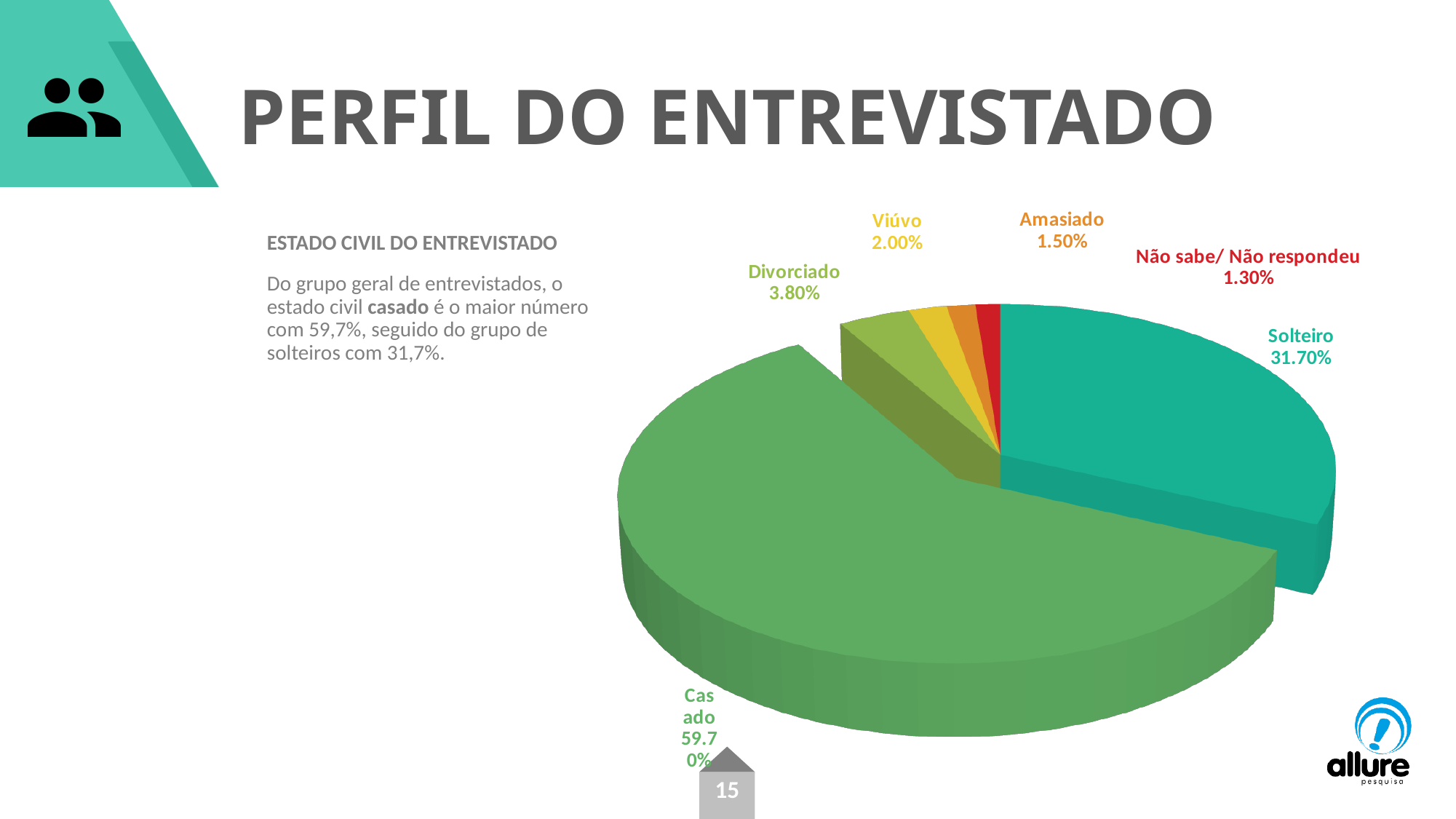
What kind of chart is shown on the slide? Pie chart Which is larger, Divorciado or Viúvo? Divorciado What is the value for Casado in the pie chart? 59.70% Which category has the largest slice in the pie chart? Casado What is the value for Solteiro in the pie chart? 31.70% What is the value for Amasiado in the pie chart? 1.50% How many categories are shown in the pie chart? 6 Which category has the smallest slice in the pie chart? Não sabe/ Não respondeu What is the difference between the values for Casado and Solteiro? 28.00% What is the value for Viúvo in the pie chart? 2.00% What is the value for Divorciado in the pie chart? 3.80% What is the value for Não sabe/ Não respondeu in the pie chart? 1.30%